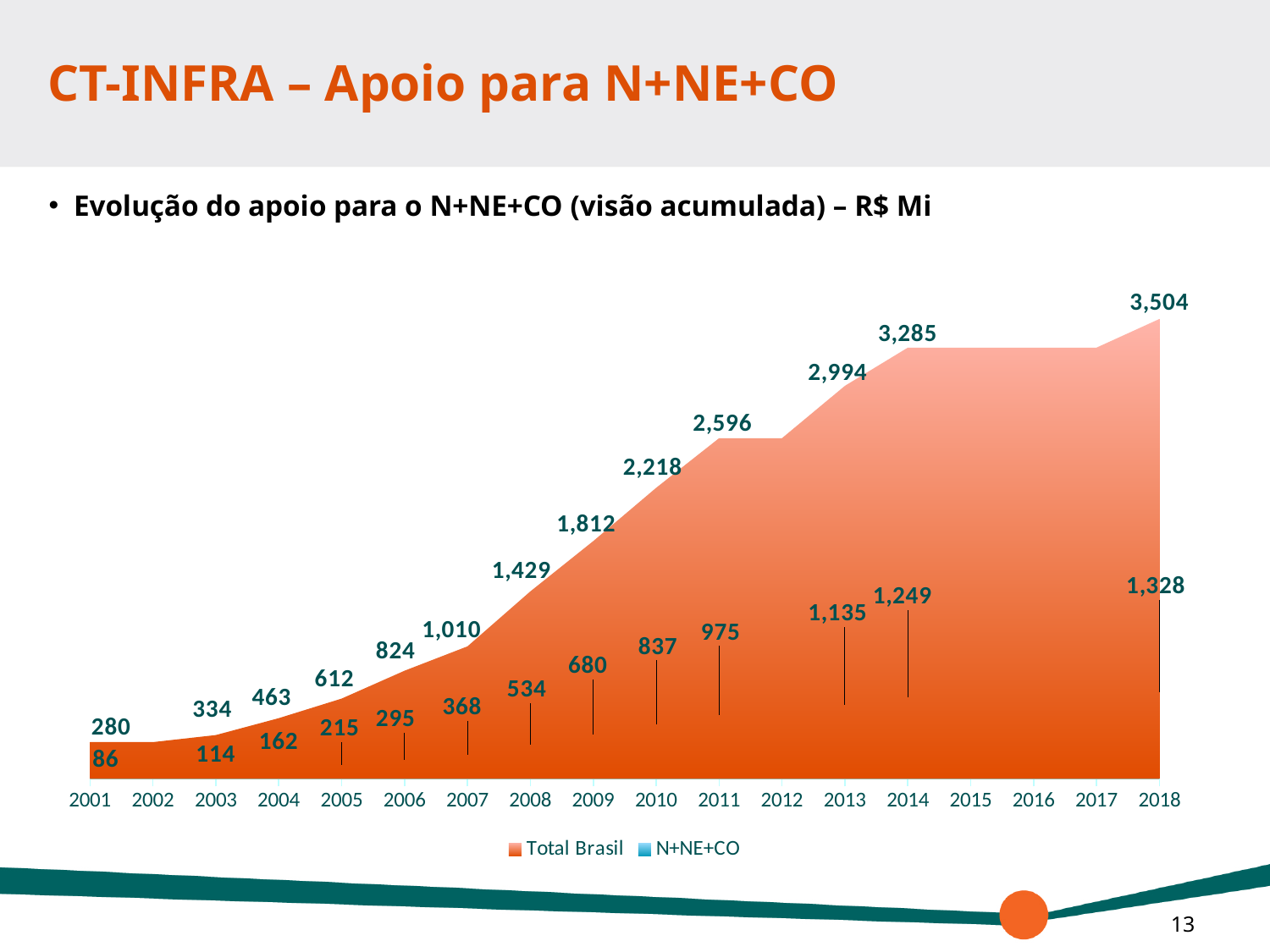
What is the N+NE+CO value for 2001? 86 What is the Total Brasil value for 2001? 280 What is the difference between the Total Brasil and N+NE+CO values in 2001? 194 What is the Total Brasil value for 2018? 3,504 How many series does the legend list? 2 How many years are shown on the x axis? 18 Do the Total Brasil values rise or fall from 2001 to 2018? Rise What is the N+NE+CO value for 2009? 680 What is the N+NE+CO value for 2018? 1,328 In which year is the Total Brasil value highest? 2018 What is the difference between the Total Brasil and N+NE+CO values in 2018? 2,176 What type of chart is shown on the slide? Area chart